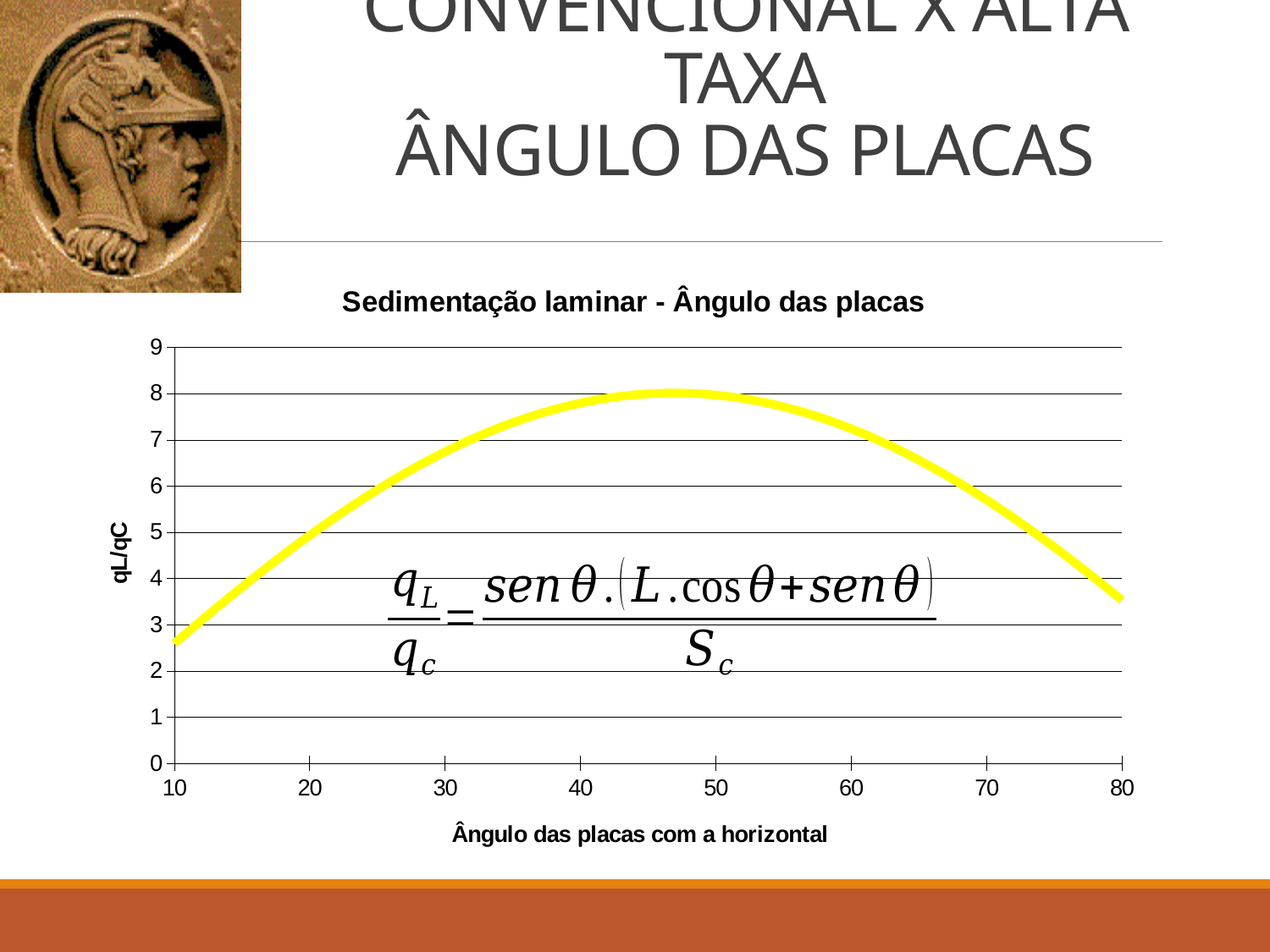
Which has the larger qL/qC value: an angle of 10 or an angle of 80? 80 Does the curve rise or fall as the angle increases from 10 to 40? rises Is the value of qL/qC at an angle of 30 greater or less than 6? greater What is the label of the x axis of the chart? Ângulo das placas com a horizontal Is the value of qL/qC at an angle of 40 greater or less than 7? greater Is the value of qL/qC at an angle of 50 greater or less than 7? greater What is the title of the chart? Sedimentação laminar - Ângulo das placas Which has the larger qL/qC value: an angle of 50 or an angle of 10? 50 What kind of chart is shown on the slide? line chart Does the curve rise or fall as the angle increases from 60 to 80? falls